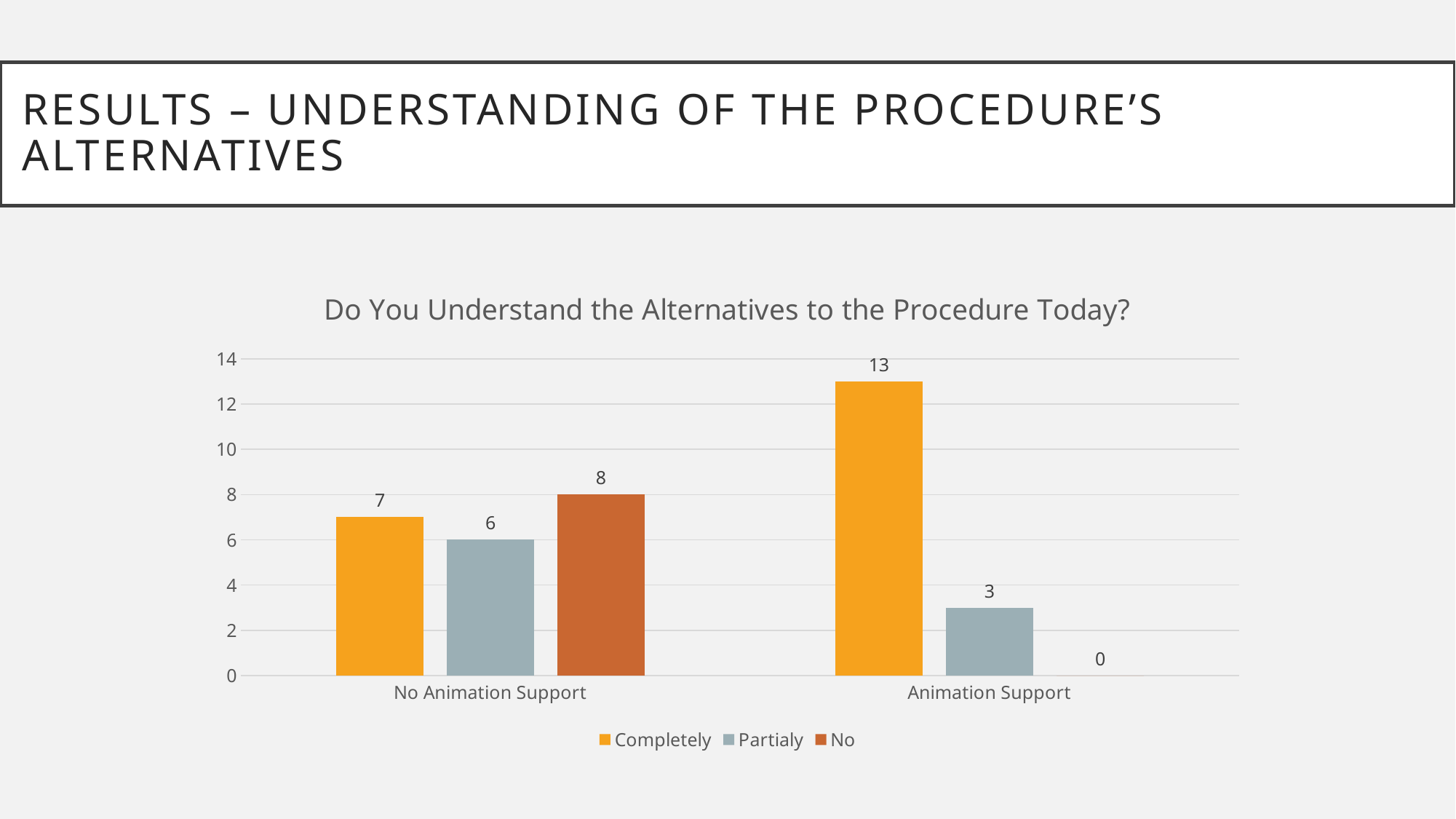
What is the title of the chart? Do You Understand the Alternatives to the Procedure Today? Which series has the lowest value in the Animation Support group? No What is the value for No in the Animation Support group? 0 What kind of chart is shown on the slide? Bar chart What is the value for Partialy in the Animation Support group? 3 How many categories are shown on the x axis? 2 What is the value for No in the No Animation Support group? 8 What is the difference between the Completely values for Animation Support and No Animation Support? 6 What is the value for Completely in the Animation Support group? 13 Which is larger: Partialy for No Animation Support or Partialy for Animation Support? No Animation Support How many series does the legend list? 3 Which series has the highest value in the No Animation Support group? No